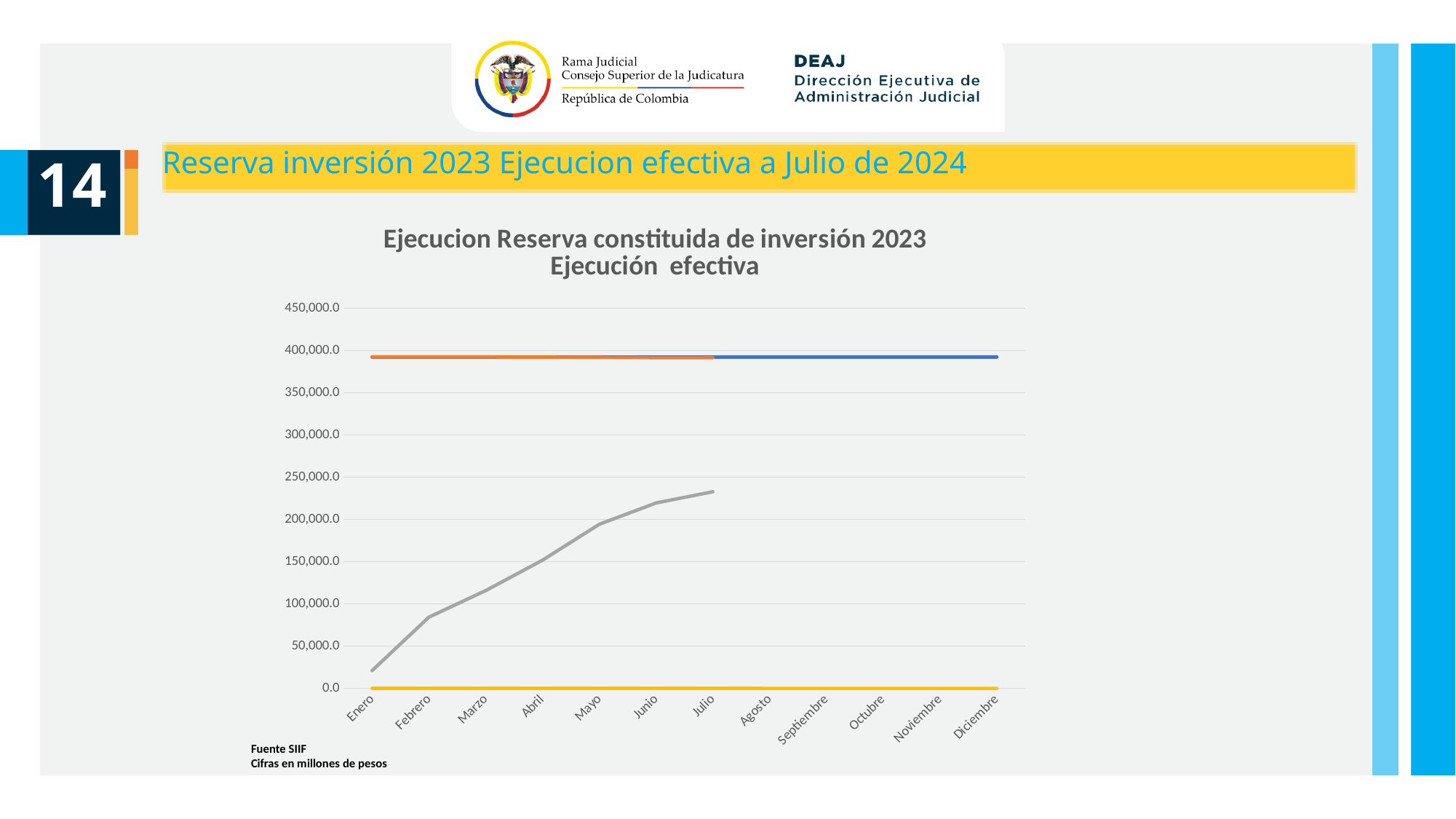
In Julio, which is larger: the value of the orange line or the value of the gray line? the orange line What is the title of the chart? Ejecucion Reserva constituida de inversión 2023 Ejecución efectiva Is the value of the gray line in Marzo greater or less than 100,000.0? greater What kind of chart is shown on the slide? line chart Is the value of the gray line in Junio greater or less than 200,000.0? greater How many months are labelled along the x axis of the chart? 12 In which month does the gray line reach its highest point? Julio Is the value of the orange line in Enero greater or less than 400,000.0? less Does the gray line rise or fall from Enero to Julio? rises According to the note below the chart, what is the source of the data? SIIF